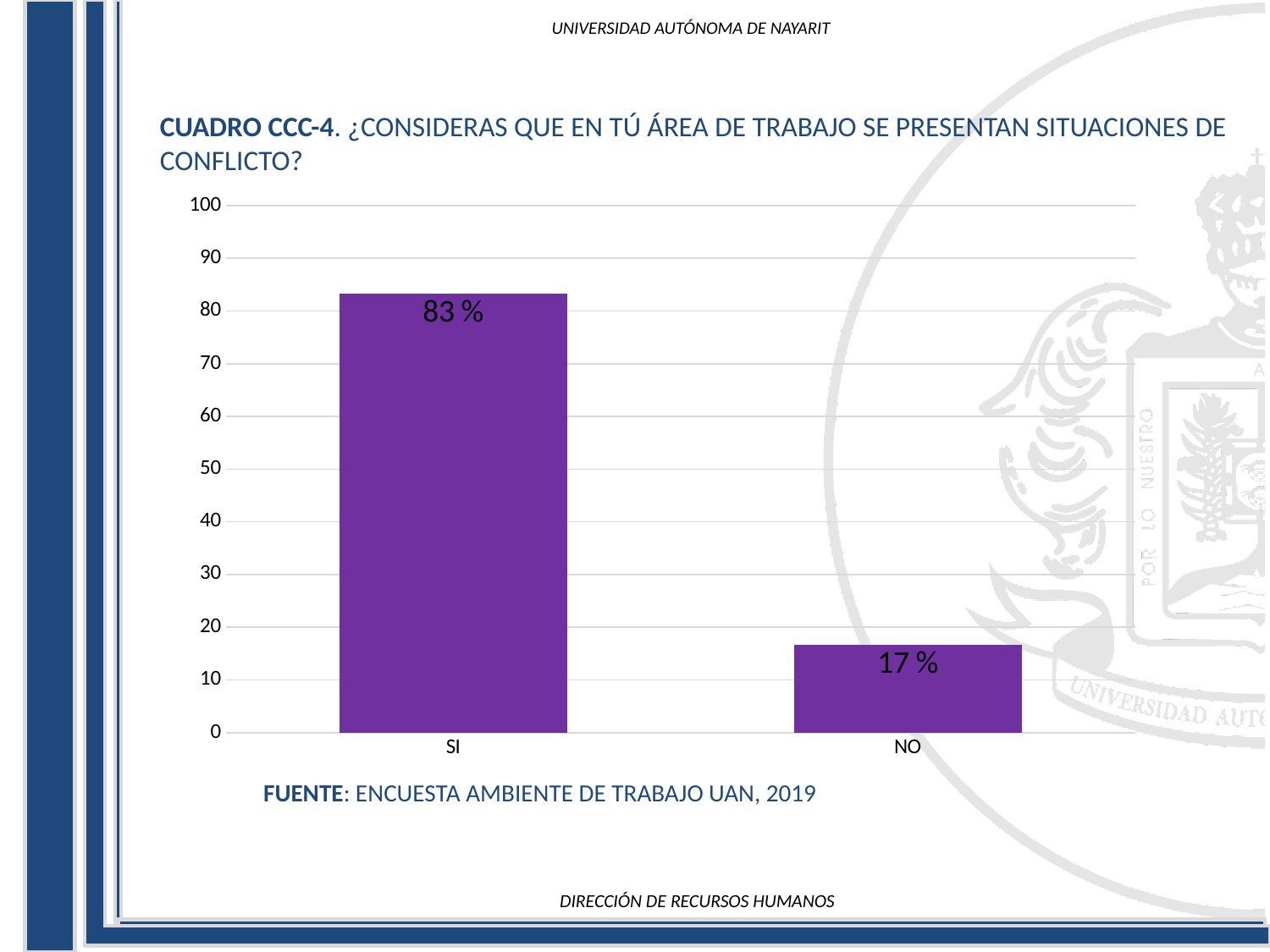
How many categories are shown on the x axis? 2 What is the difference between the values for SI and NO? 66 % Is the value for NO greater or less than 20? less Which category has the highest value? SI Is the value for SI greater or less than 80? greater Which category has the lowest value? NO What is the value for SI? 83 % What is the source cited below the chart? ENCUESTA AMBIENTE DE TRABAJO UAN, 2019 What is the value for NO? 17 % What kind of chart is shown on the slide? bar chart Which is larger, the value for SI or the value for NO? SI What is the highest value shown on the y axis? 100